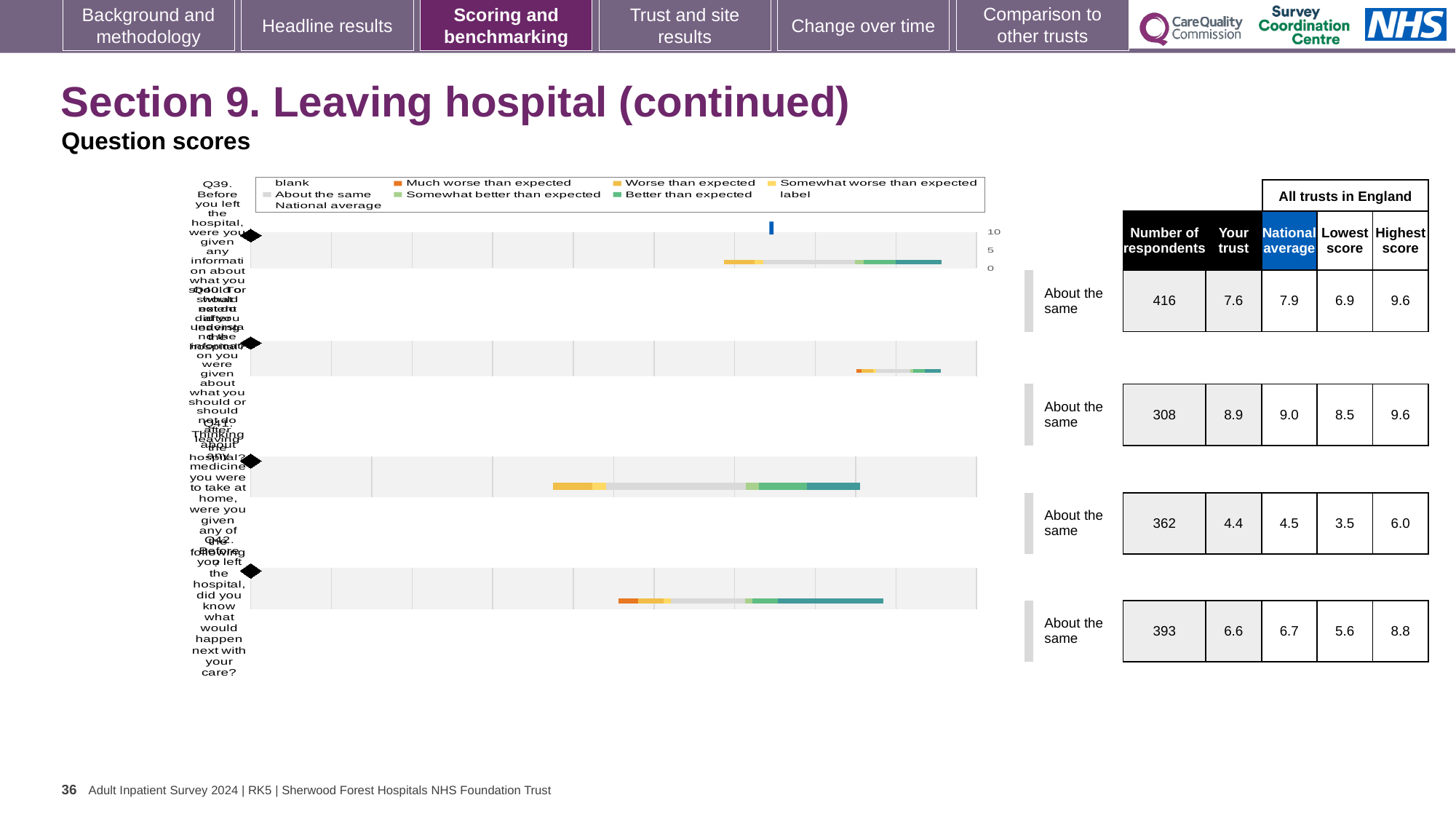
What is the maximum value shown on the chart's score axis? 10 In the table beside the chart, what is the national average score for Q42? 6.7 In the table beside the chart, how many respondents answered Q40? 308 Which question has the highest number of respondents in the table beside the chart? Q39 How many questions (rows) are plotted in the chart? 4 Which question has the lowest 'Your trust' score in the table beside the chart? Q41 For Q39, what is the difference between the highest score and the lowest score across all trusts in England? 2.7 For Q42, what is the difference between the highest score (8.8) and the 'Your trust' score (6.6)? 2.2 For Q40, which is larger: the 'Your trust' score or the national average? National average In the table beside the chart, what is the 'Your trust' score for Q41? 4.4 What benchmark category is shown for all four questions in the chart? About the same What kind of chart is used to show the question scores on this slide? bar chart